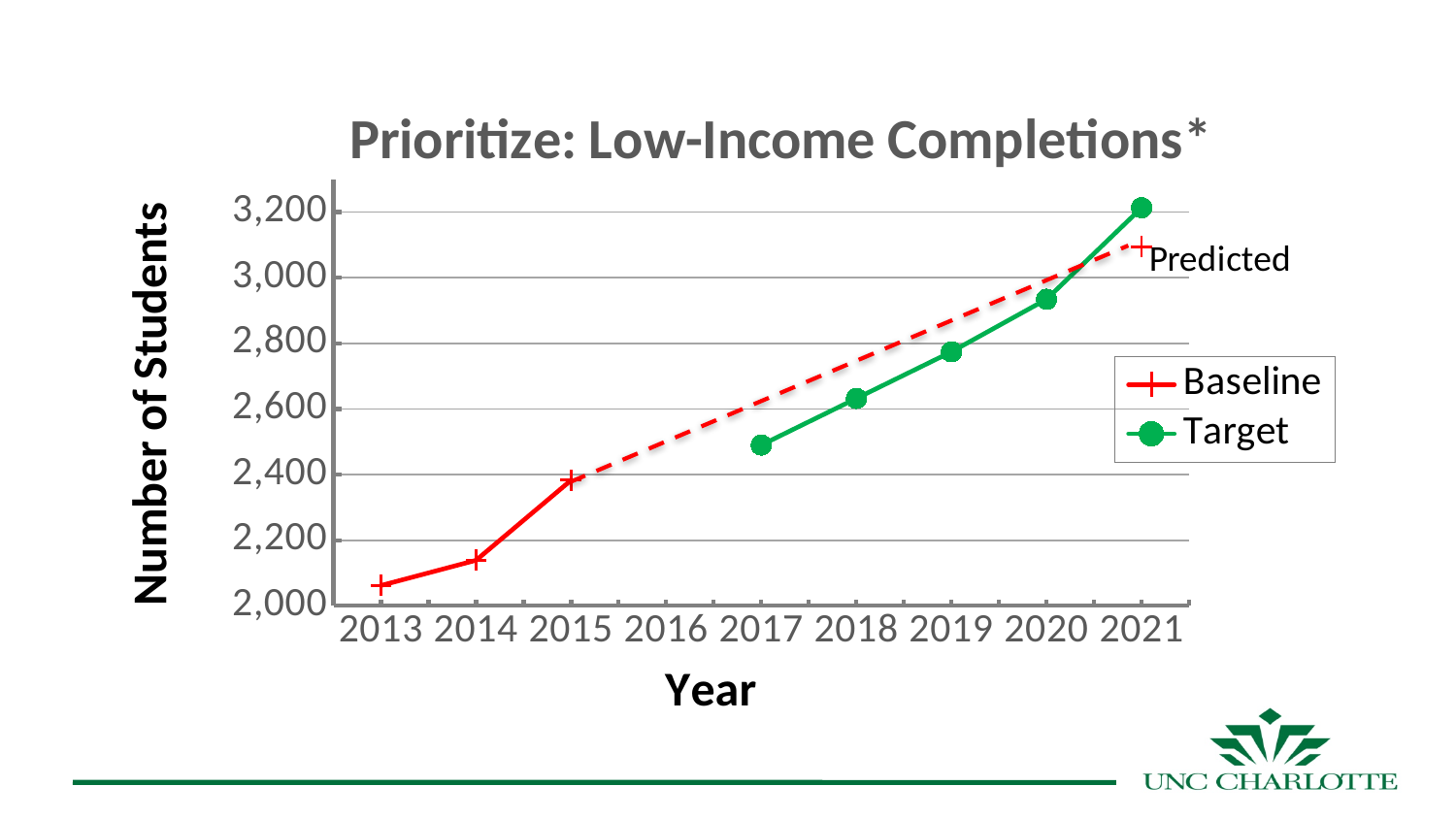
How many series does the legend list? 2 What is the title of the chart? Prioritize: Low-Income Completions* How many years are labelled on the x axis? 9 Is the Baseline (Predicted) value for 2021 greater or less than 3,000? greater In 2021, which series has the higher value, Baseline or Target? Target How many data points does the Target series have? 5 What kind of chart is shown on the slide? line chart Is the Target value for 2017 greater or less than 2,400? greater Is the Target value for 2020 greater or less than 3,000? less What are the two series named in the legend? Baseline and Target Does the Target series rise or fall from 2017 to 2021? rise